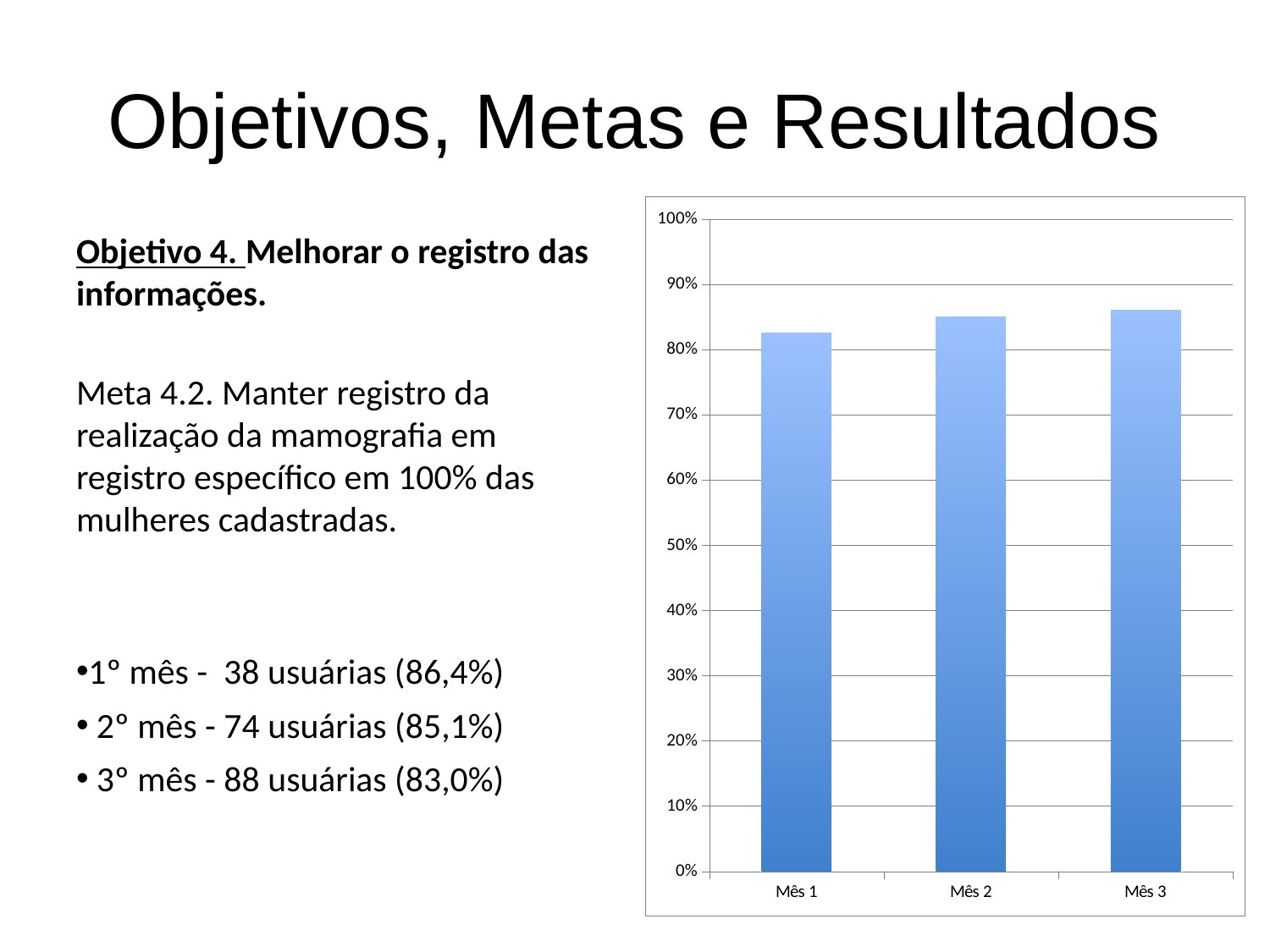
What is the highest value shown on the chart's vertical axis? 100% Which month has the lowest bar on the chart? Mês 1 Which bar is taller, Mês 1 or Mês 3? Mês 3 How many categories (months) are plotted on the chart? 3 Is the value for Mês 1 greater or less than 80%? greater Is the value for Mês 3 greater or less than 90%? less What is the label of the first category on the horizontal axis? Mês 1 What kind of chart is shown on the slide? bar chart Is the value for Mês 1 greater or less than 90%? less Do the bar values rise or fall from Mês 1 to Mês 3? rise